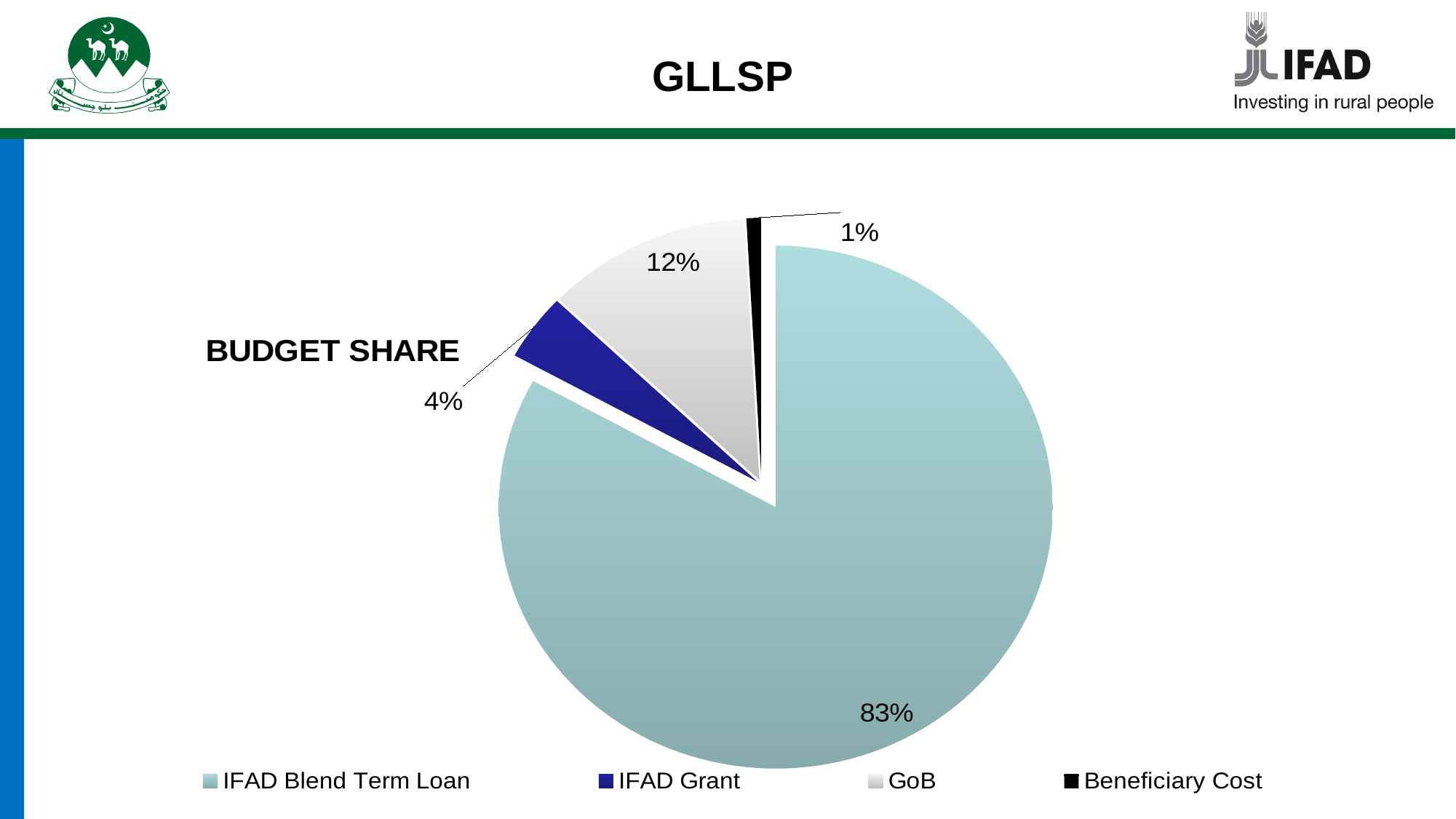
What is the budget share for Beneficiary Cost? 1% Which category has the smallest share of the budget? Beneficiary Cost What is the budget share for IFAD Grant? 4% Which category has the largest share of the budget? IFAD Blend Term Loan Which is larger, the share for GoB or the share for IFAD Grant? GoB What is the budget share for IFAD Blend Term Loan? 83% What is the title of the pie chart? BUDGET SHARE What is the budget share for GoB? 12% Which colour represents IFAD Grant in the legend? dark blue What is the difference in percentage points between the GoB share and the IFAD Grant share? 8 What kind of chart is shown on the slide? pie chart How many categories does the pie chart show? 4